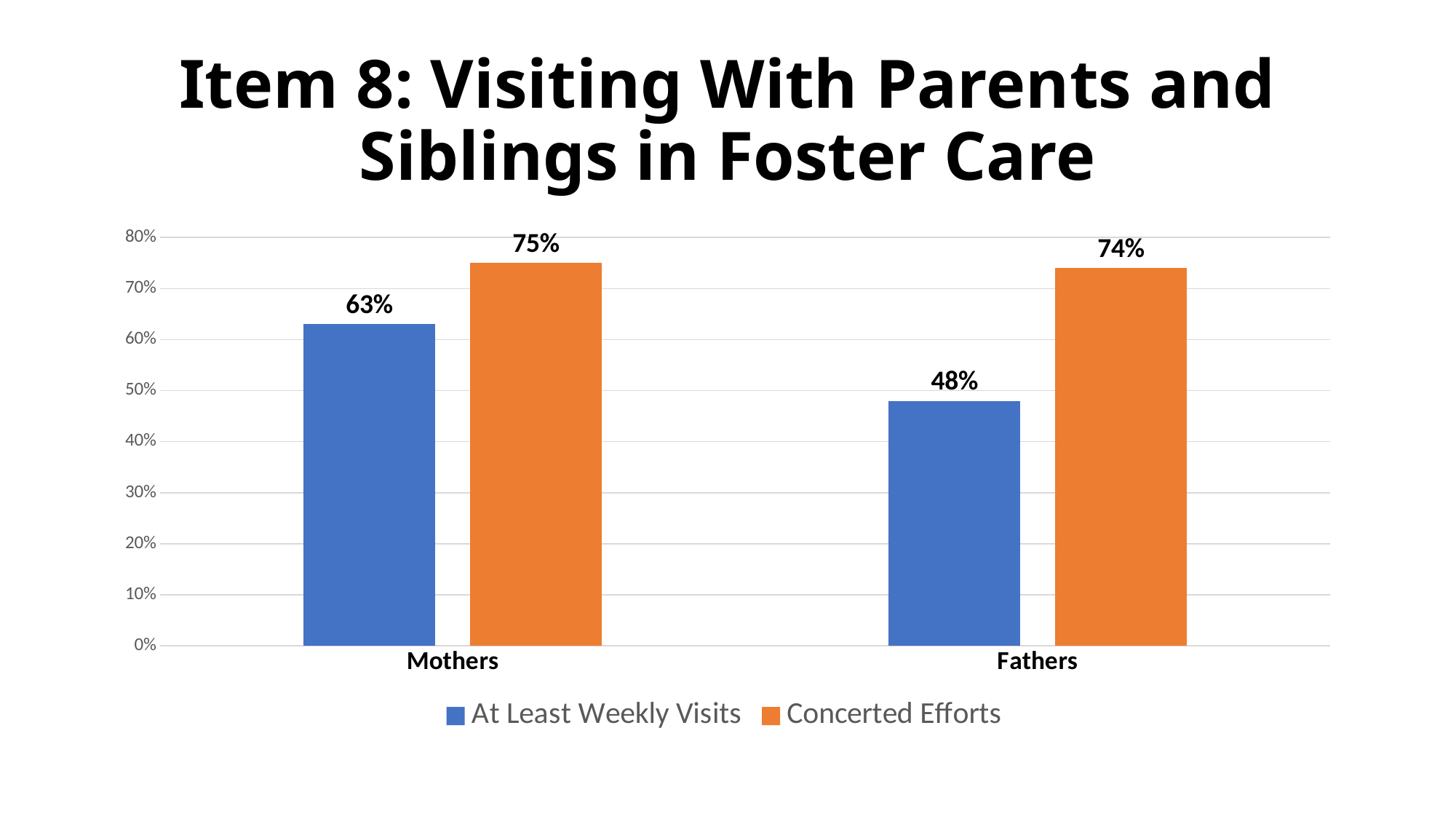
What is the value for Concerted Efforts for Mothers? 75% What is the value for Concerted Efforts for Fathers? 74% What kind of chart is shown on the slide? Bar chart Which is larger for Mothers: At Least Weekly Visits or Concerted Efforts? Concerted Efforts What is the difference between Concerted Efforts and At Least Weekly Visits for Fathers? 26% How many categories are shown on the x axis? 2 Which category has the lowest value for At Least Weekly Visits? Fathers Is the value for At Least Weekly Visits for Fathers greater or less than 50%? less What is the difference between the At Least Weekly Visits values for Mothers and Fathers? 15% What is the value for At Least Weekly Visits for Fathers? 48% How many series does the legend list? 2 What is the value for At Least Weekly Visits for Mothers? 63%